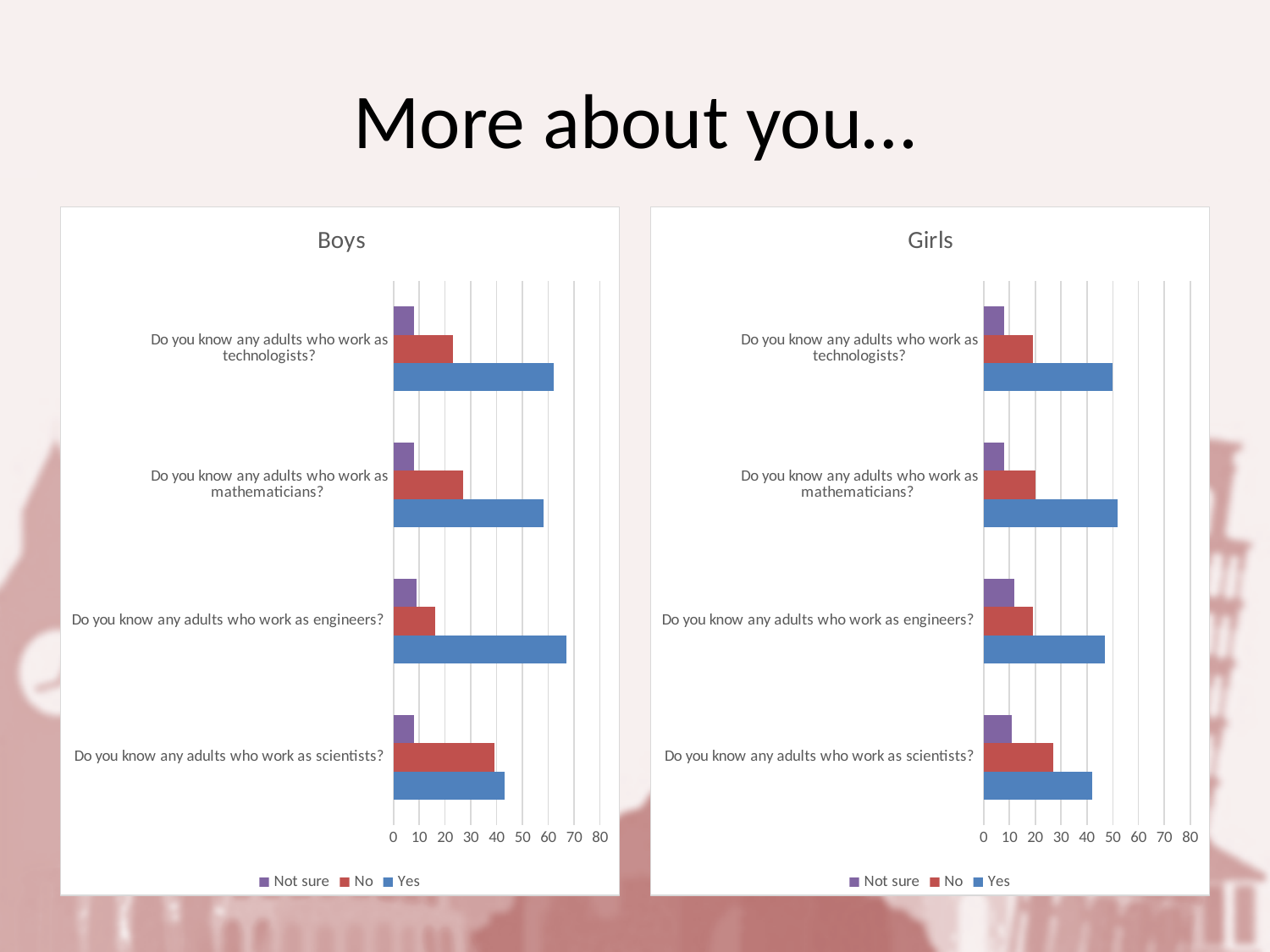
In the Girls chart, which question has the highest No value? Do you know any adults who work as scientists? In the Girls chart, is the Yes value for 'Do you know any adults who work as technologists?' greater or less than 60? less In the Boys chart, which question has the highest Yes value? Do you know any adults who work as engineers? Is the Yes value for 'Do you know any adults who work as engineers?' larger in the Boys chart or the Girls chart? Boys What kind of chart is the Boys chart? bar chart In the Boys chart, is the Yes value for 'Do you know any adults who work as engineers?' greater or less than 60? greater How many question categories are shown on the Boys chart? 4 In the Boys chart, which question has the lowest Yes value? Do you know any adults who work as scientists? What are the legend entries of the Boys chart? Not sure, No, Yes In the Boys chart, which is larger: the No value for scientists or the No value for engineers? No value for scientists How many series does the legend of the Girls chart list? 3 In the Boys chart, is the No value for 'Do you know any adults who work as scientists?' greater or less than 30? greater